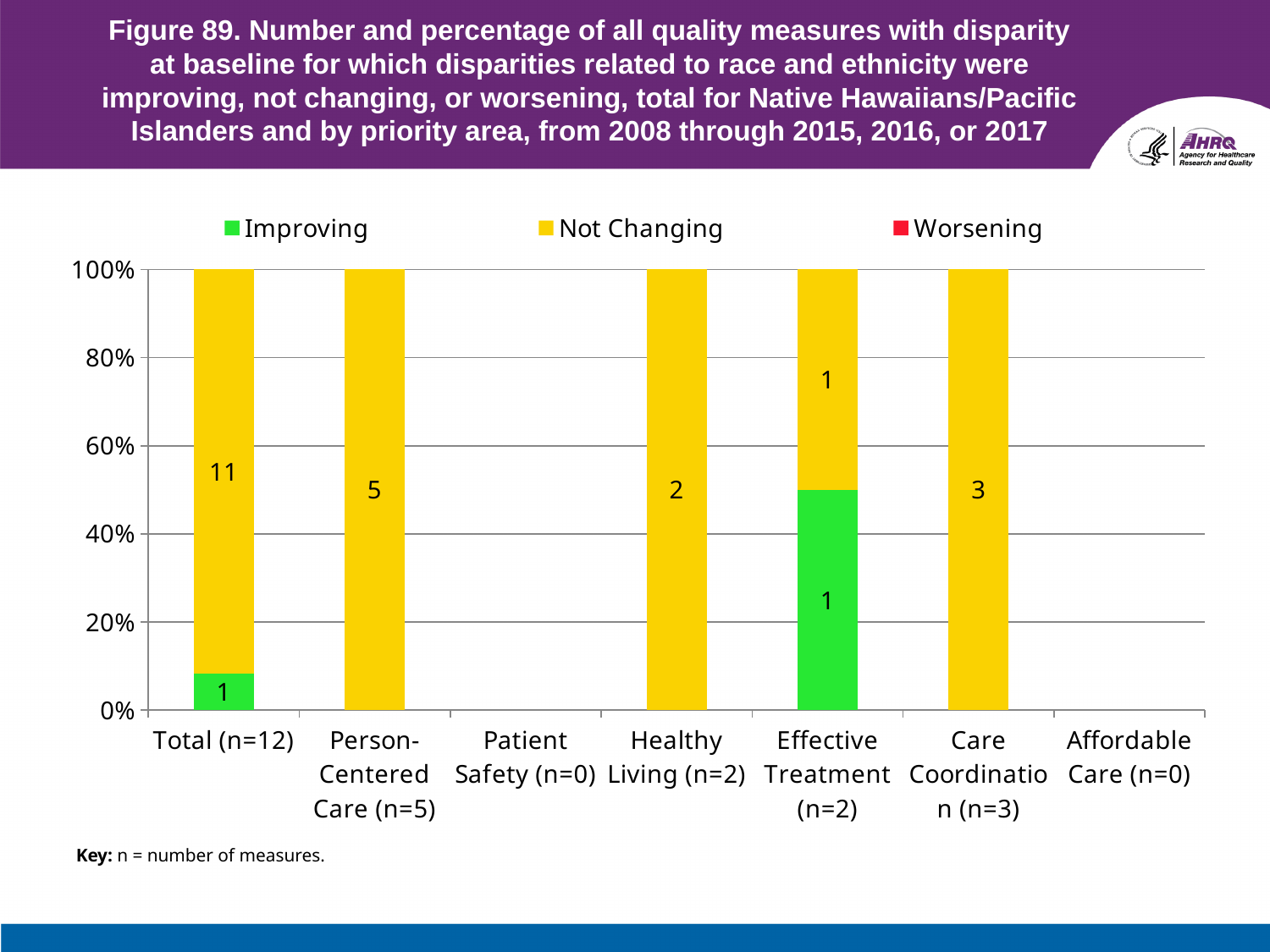
What is the Not Changing value for Total (n=12)? 11 What is the Not Changing value for Person-Centered Care (n=5)? 5 What is the difference between the Not Changing and Improving values for Total (n=12)? 10 What is the Not Changing value for Care Coordination (n=3)? 3 What is the Improving value for Effective Treatment (n=2)? 1 Which legend entry is shown in red? Worsening Which category has the highest Not Changing value? Total (n=12) How many categories are shown on the x axis? 7 What kind of chart is shown on the slide? Stacked bar chart How many series does the legend list? 3 Is the Not Changing value for Person-Centered Care larger than the Not Changing value for Healthy Living? Yes What is the Improving value for Total (n=12)? 1